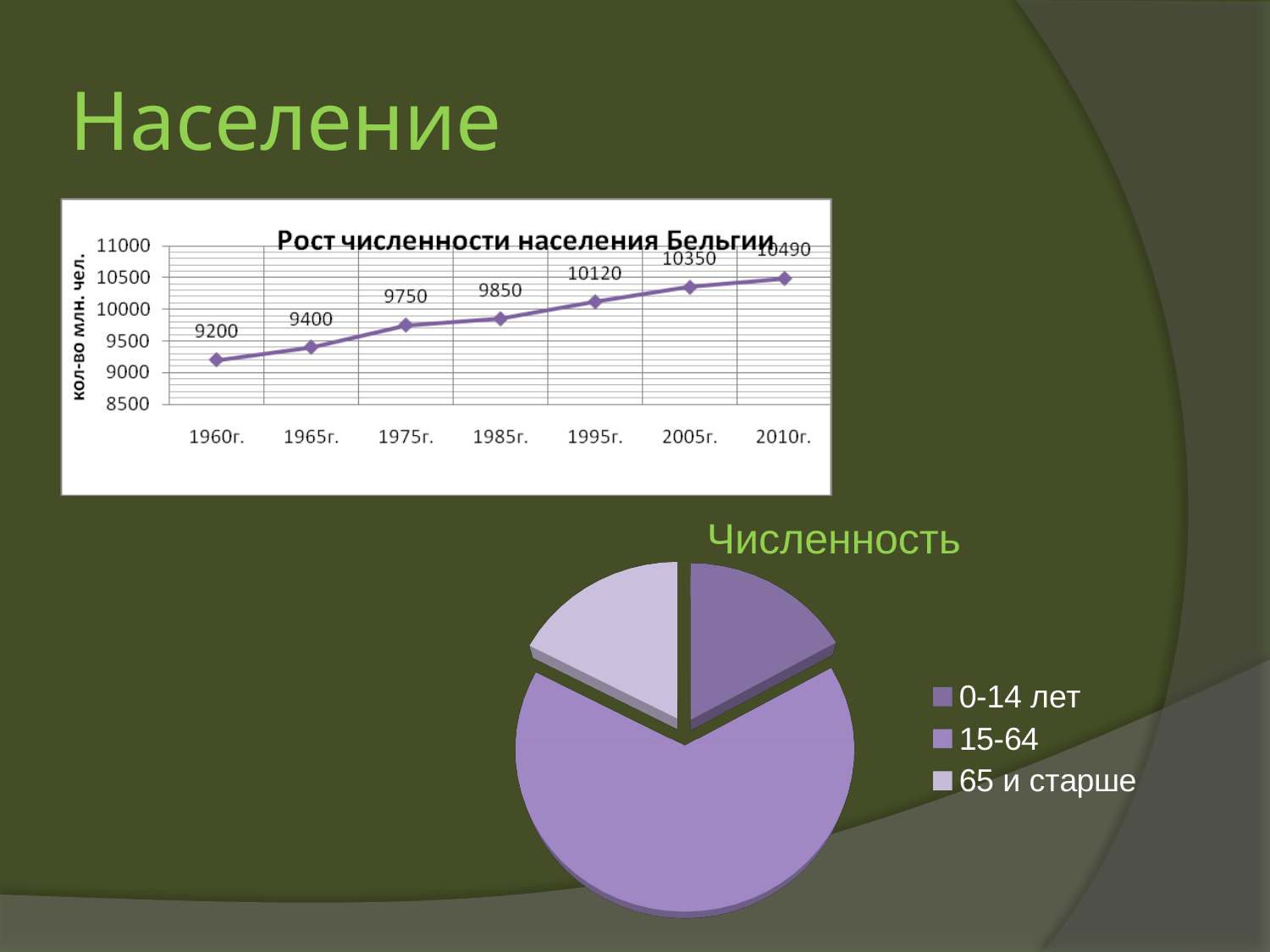
How many categories does the legend of the pie chart 'Численность' list? 3 In the chart 'Рост численности населения Бельгии', which year has the lowest value? 1960г. In the chart 'Рост численности населения Бельгии', what is the value for 1960г.? 9200 What kind of chart is 'Рост численности населения Бельгии'? line chart In the chart 'Рост численности населения Бельгии', what is the value for 2010г.? 10490 In the chart 'Рост численности населения Бельгии', which is larger, the value for 2005г. or the value for 1995г.? 2005г. In the chart 'Рост численности населения Бельгии', what is the difference between the values for 1985г. and 1975г.? 100 In the chart 'Рост численности населения Бельгии', do the values rise or fall from 1960г. to 2010г.? rise In the chart 'Рост численности населения Бельгии', what is the value for 1995г.? 10120 In the chart 'Рост численности населения Бельгии', which year has the highest value? 2010г. How many data points are plotted in the chart 'Рост численности населения Бельгии'? 7 In the chart 'Рост численности населения Бельгии', what is the difference between the values for 2010г. and 1960г.? 1290